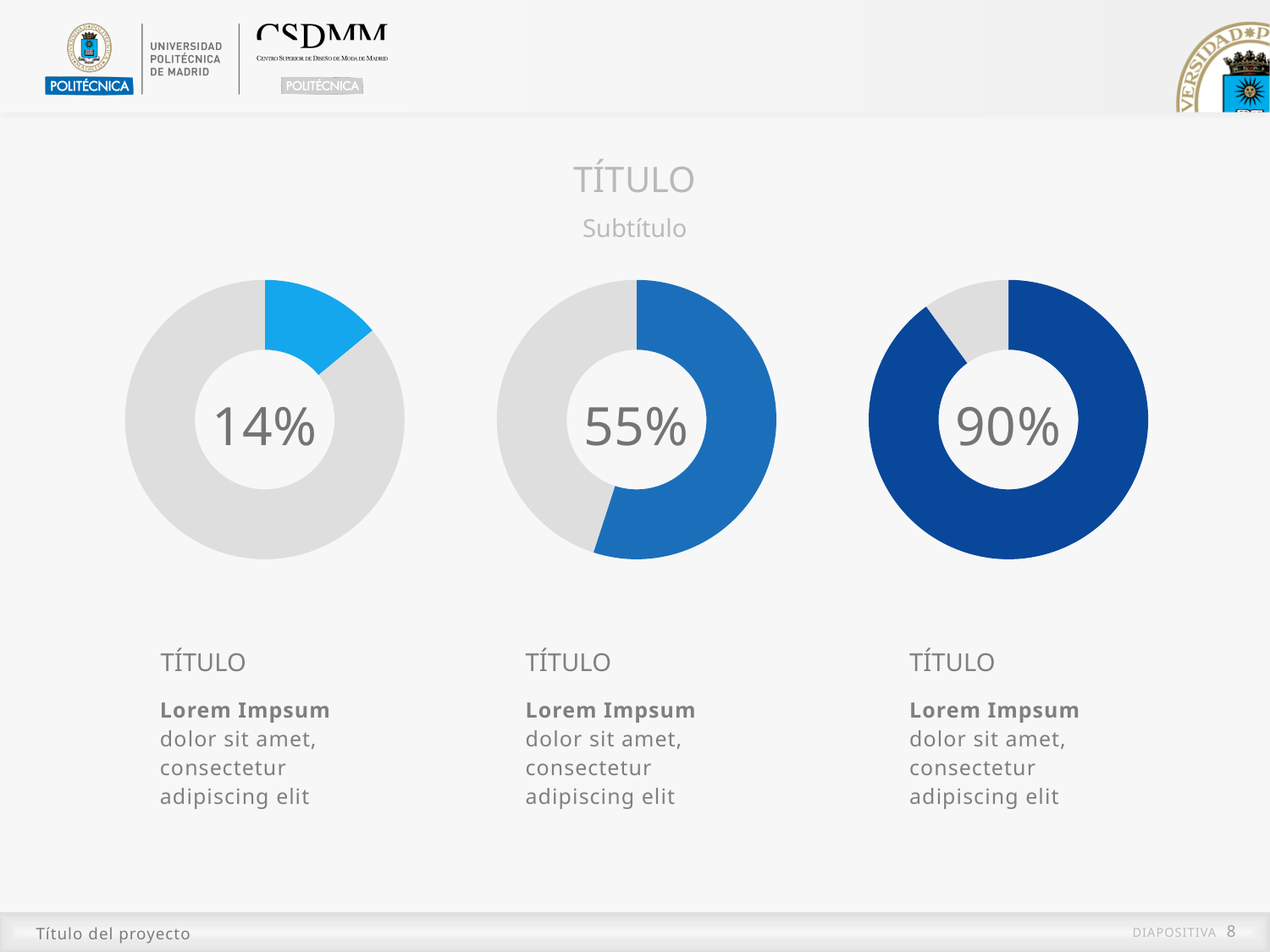
What is the difference between the percentage in the middle donut chart and the percentage in the left donut chart? 41% How many donut charts are on the slide? 3 What colour is the filled segment of the left donut chart? light blue What is the difference between the percentage in the right donut chart and the percentage in the left donut chart? 76% What percentage is shown in the centre of the middle donut chart? 55% What percentage is shown in the centre of the right donut chart? 90% Which of the three donut charts shows the lowest percentage: left, middle or right? left What kind of chart is used to display the three percentages on the slide? donut chart In the right donut chart, what share of the ring is filled with the dark blue colour? 90% What percentage is shown in the centre of the left donut chart? 14% Which of the three donut charts shows the highest percentage: left, middle or right? right Is the percentage in the middle donut chart larger or smaller than the percentage in the right donut chart? smaller